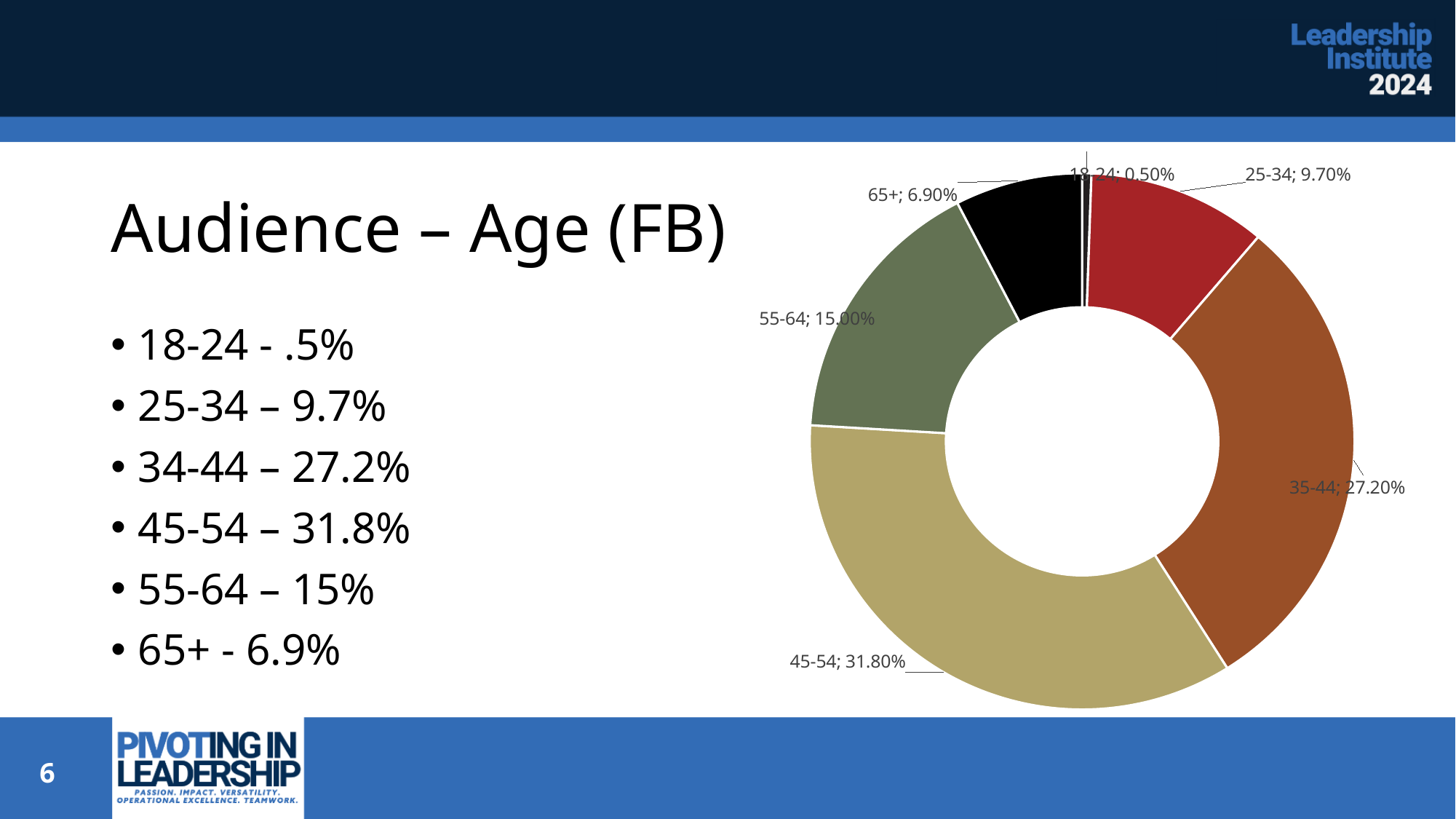
What is the value for the 45-54 age group in the chart? 31.80% What is the value for the 25-34 age group in the chart? 9.70% What is the value for the 65+ age group in the chart? 6.90% What colour is the 45-54 segment in the chart? Tan (khaki) What is the value for the 55-64 age group in the chart? 15.00% How many age groups are shown in the chart? 6 Which age group has the smallest share in the chart? 18-24 Which age group has the largest share in the chart? 45-54 What is the combined share of the 18-24 and 25-34 groups in the chart? 10.20% Which is larger in the chart, the share for 55-64 or the share for 25-34? 55-64 What is the difference between the 45-54 and 35-44 shares in the chart? 4.60% What kind of chart is shown on the slide? Doughnut chart